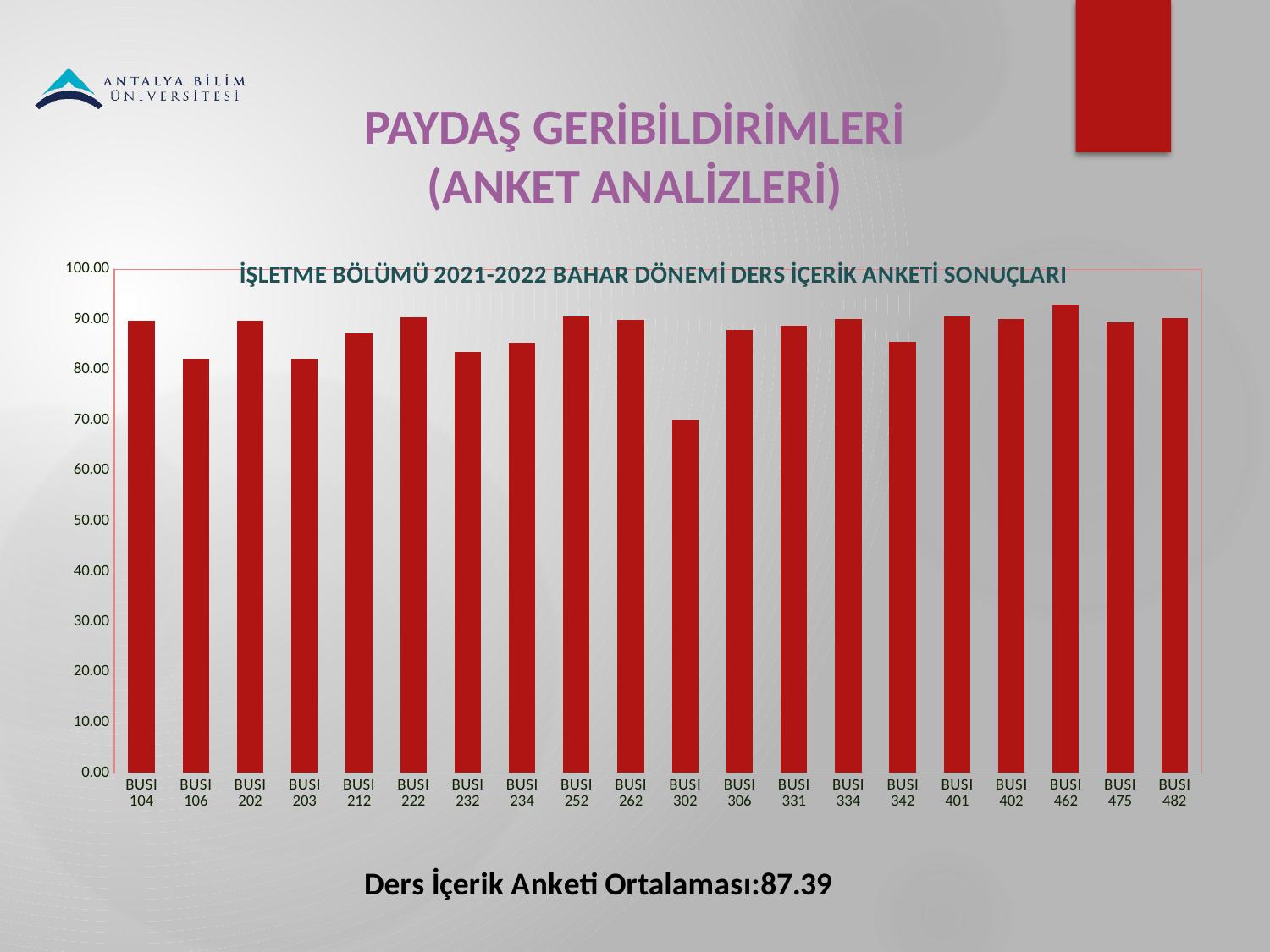
What kind of chart is shown on the slide? bar chart What is the title of the chart? İŞLETME BÖLÜMÜ 2021-2022 BAHAR DÖNEMİ DERS İÇERİK ANKETİ SONUÇLARI Is the value for BUSI 342 greater or less than 90? less How many courses (categories) are plotted on the chart? 20 Which is larger, the value for BUSI 302 or the value for BUSI 306? BUSI 306 What is the Ders İçerik Anketi average stated below the chart? 87.39 Is the value for BUSI 104 greater or less than 80? greater Is the value for BUSI 106 greater or less than 90? less Which course has the highest value on the chart? BUSI 462 Which course has the lowest value on the chart? BUSI 302 Which is larger, the value for BUSI 203 or the value for BUSI 222? BUSI 222